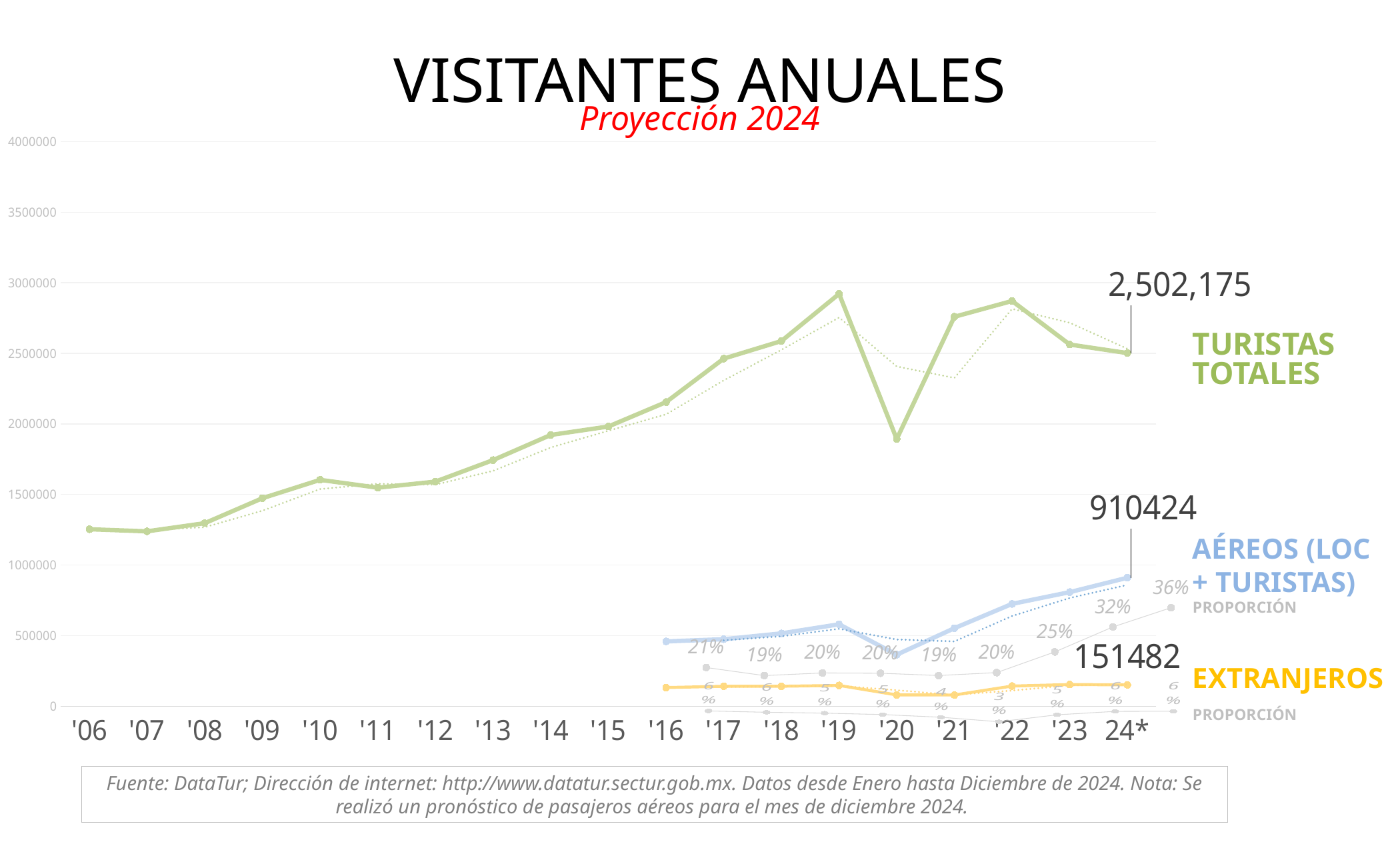
What is the value of TURISTAS TOTALES for 24*? 2,502,175 Is the value of TURISTAS TOTALES for '19 greater or less than 2500000? greater What is the value of EXTRANJEROS for 24*? 151482 What is the value of AÉREOS (LOC + TURISTAS) for 24*? 910424 What kind of chart is shown on the slide? line chart Which is larger for TURISTAS TOTALES, the value for '20 or the value for '21? '21 How many years are shown on the x axis? 19 What is the difference between the 24* values of TURISTAS TOTALES and AÉREOS (LOC + TURISTAS)? 1,591,751 Is the value of TURISTAS TOTALES for '06 greater or less than 1500000? less